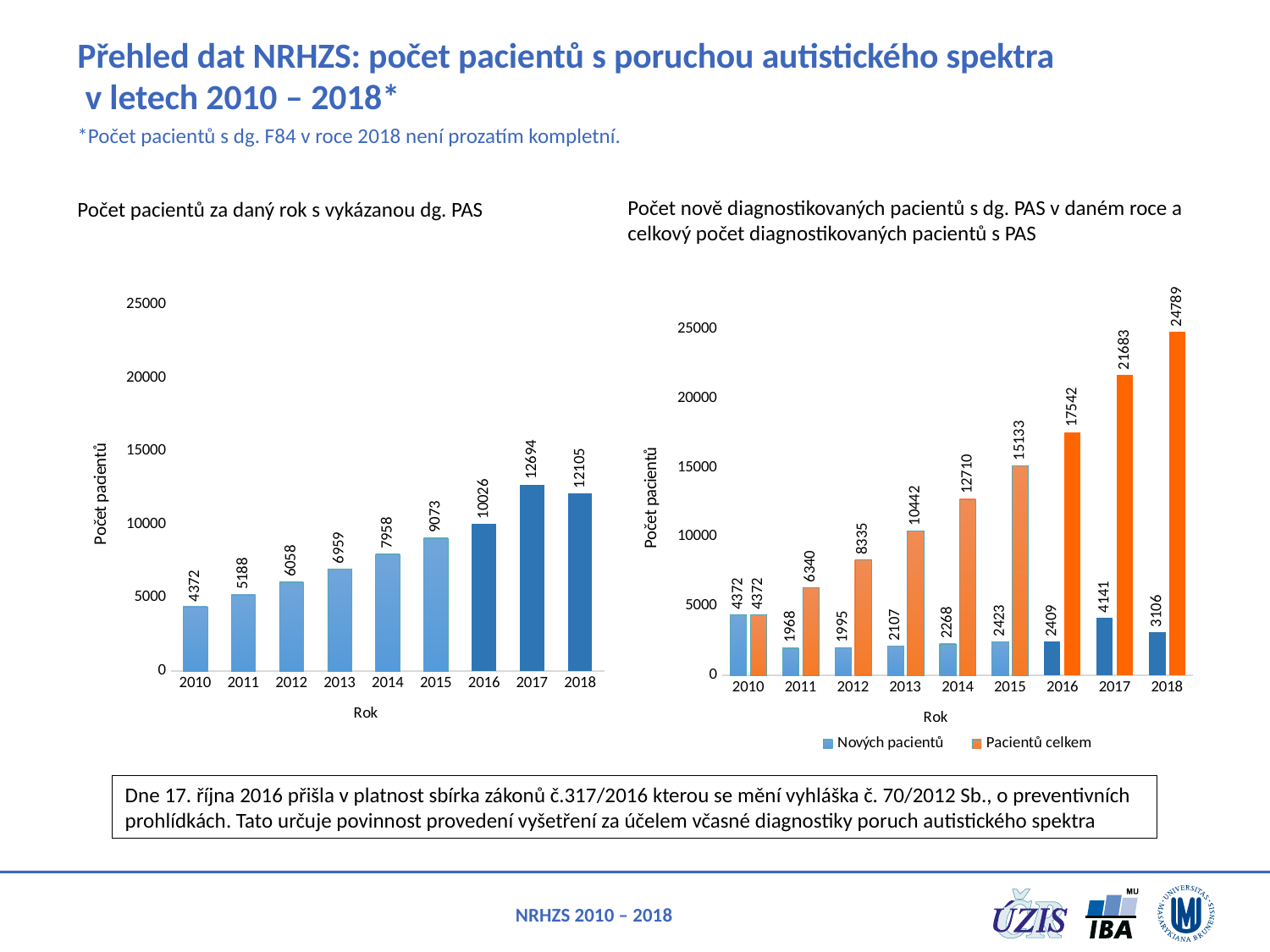
In the right chart (Počet nově diagnostikovaných pacientů...), what is the difference between Pacientů celkem in 2018 and 2017? 3106 In the right chart (Počet nově diagnostikovaných pacientů...), does the Pacientů celkem series rise or fall from 2010 to 2018? rise In the right chart (Počet nově diagnostikovaných pacientů...), what is the value of Pacientů celkem for 2014? 12710 In the left chart (Počet pacientů za daný rok s vykázanou dg. PAS), which year has the highest value? 2017 What kind of chart is the left chart (Počet pacientů za daný rok s vykázanou dg. PAS)? bar chart In the right chart (Počet nově diagnostikovaných pacientů...), how many series does the legend list? 2 In the left chart (Počet pacientů za daný rok s vykázanou dg. PAS), how many years are shown on the x axis? 9 In the left chart (Počet pacientů za daný rok s vykázanou dg. PAS), what is the difference between the values for 2017 and 2018? 589 In the left chart (Počet pacientů za daný rok s vykázanou dg. PAS), which year has the lowest value? 2010 In the right chart (Počet nově diagnostikovaných pacientů...), what is the value of Nových pacientů for 2017? 4141 In the left chart (Počet pacientů za daný rok s vykázanou dg. PAS), what is the value for 2015? 9073 In the right chart (Počet nově diagnostikovaných pacientů...), which is larger: Nových pacientů in 2017 or Nových pacientů in 2018? Nových pacientů in 2017